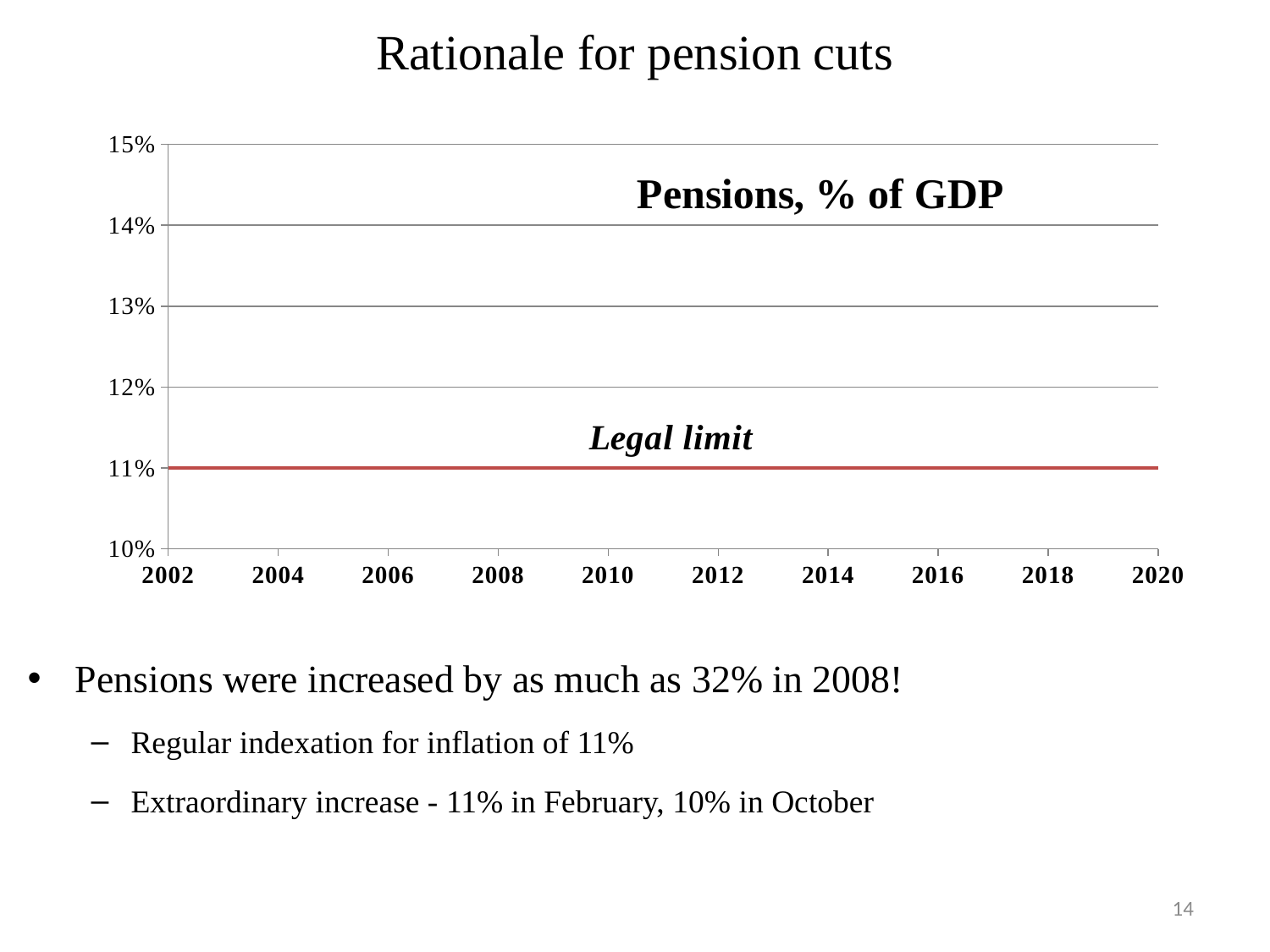
What is the highest value shown on the y axis of the chart? 15% At what value on the y axis does the red 'Legal limit' line sit? 11% What is the label on the red horizontal line in the chart? Legal limit What is the first year shown on the x axis of the chart? 2002 What is the last year shown on the x axis of the chart? 2020 Does the 'Legal limit' line rise, fall, or stay flat from 2002 to 2020? stays flat What is the lowest value shown on the y axis of the chart? 10% Is the 'Legal limit' line greater or less than 12%? less What kind of chart is shown on the slide? line chart Is the 'Legal limit' line greater or less than 10%? greater What is the title of the chart? Pensions, % of GDP